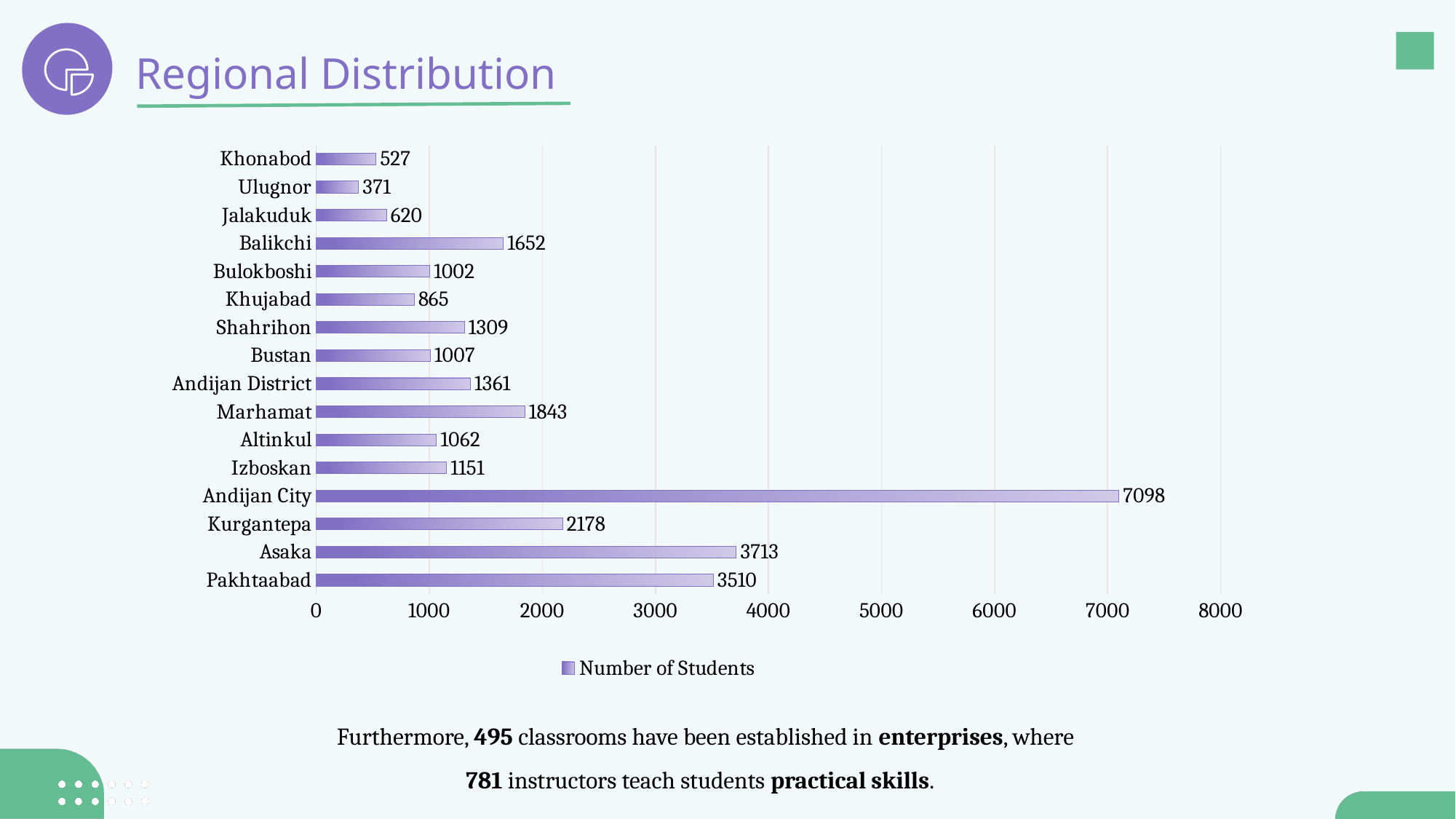
Is the value for Shahrihon greater or less than 1000? greater How many series does the legend list? 1 Which has more students, Balikchi or Kurgantepa? Kurgantepa What is the legend entry for the series in the chart? Number of Students What is the number of students for Marhamat? 1843 Which region has the highest number of students? Andijan City What is the number of students for Ulugnor? 371 Which region has the lowest number of students? Ulugnor What kind of chart is shown on the slide? Bar chart What is the difference in number of students between Asaka and Pakhtaabad? 203 How many regions are shown in the chart? 16 What is the number of students for Andijan City? 7098